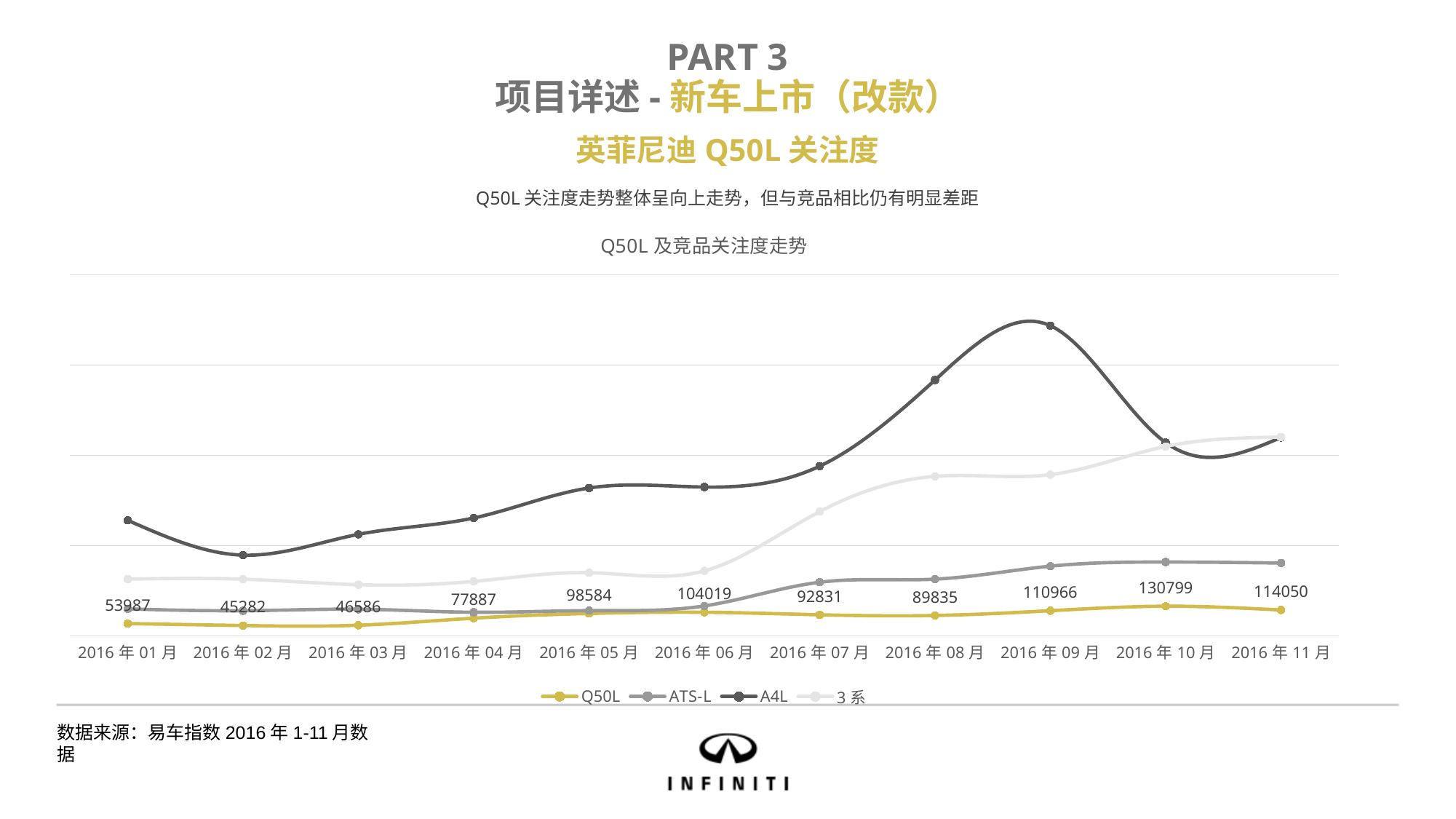
In which month is the Q50L value highest? 2016年10月 What is the Q50L value for 2016年01月? 53987 What is the Q50L value for 2016年10月? 130799 In which month is the Q50L value lowest? 2016年02月 How many months are plotted along the x axis? 11 What type of chart is shown on the slide? line chart In 2016年09月, which series has the higher value, A4L or Q50L? A4L What is the title of the chart? Q50L 及竞品关注度走势 Does the Q50L line overall rise or fall from 2016年01月 to 2016年11月? rise How many series does the legend list? 4 What is the difference between the Q50L values for 2016年10月 and 2016年11月? 16749 What is the Q50L value for 2016年06月? 104019